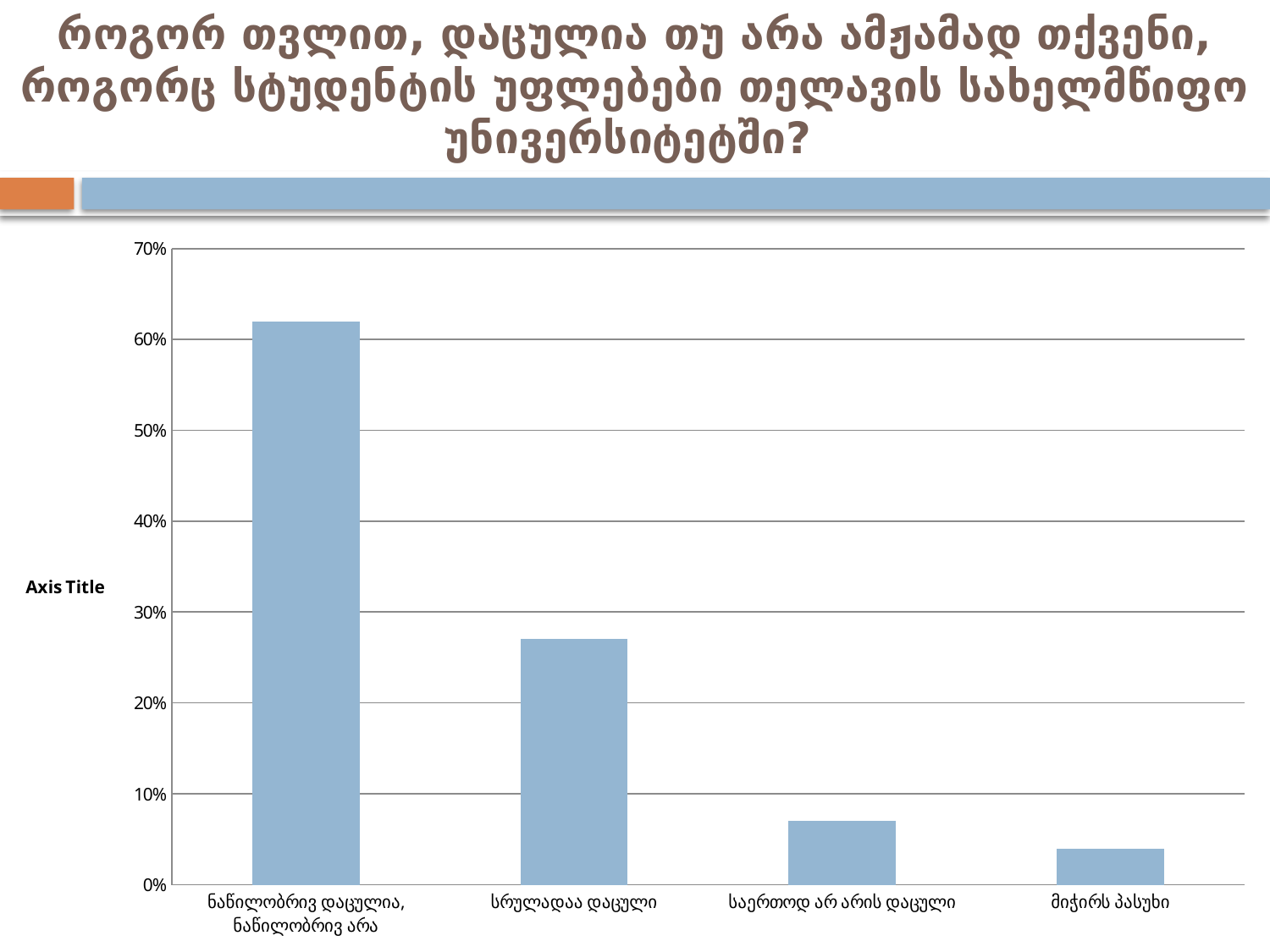
Which category has the highest bar? ნაწილობრივ დაცულია, ნაწილობრივ არა How many categories are shown on the x axis of the chart? 4 What is the highest value shown on the vertical axis of the chart? 70% Is the value for სრულადაა დაცული greater or less than 30%? less What is the label shown on the vertical axis of the chart? Axis Title What kind of chart is shown on the slide? bar chart Is the value for მიჭირს პასუხი greater or less than 10%? less Is the value for საერთოდ არ არის დაცული greater or less than 10%? less Which category has the lowest bar? მიჭირს პასუხი Which is larger, the value for სრულადაა დაცული or the value for საერთოდ არ არის დაცული? სრულადაა დაცული Do the bar values rise or fall from left to right along the x axis? fall